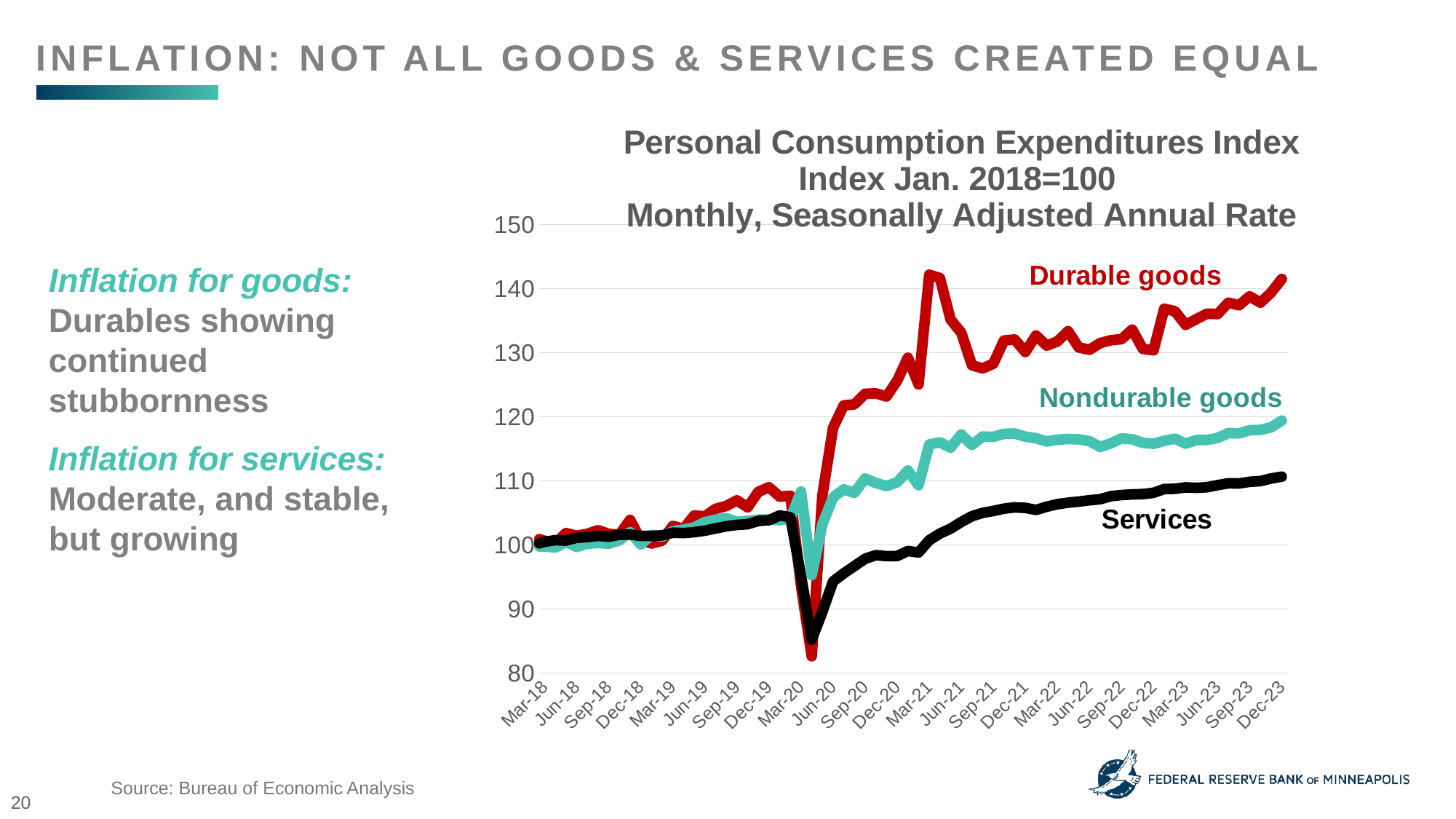
What kind of chart is shown on the slide? line chart Does the Services line generally rise or fall from Mar-21 to Dec-23? rise At Dec-23, which is larger: the value for Nondurable goods or the value for Services? Nondurable goods How many series are plotted on the chart? 3 What is the source of the data shown in the chart? Bureau of Economic Analysis What is the base period of the index according to the chart title? Jan. 2018=100 Is the value for Durable goods at Dec-23 greater or less than 130? greater Which series has the lowest value at Dec-23? Services Which series has the highest value at Dec-23? Durable goods Is the value for Services at Dec-23 greater or less than 120? less Is the value for Nondurable goods at Dec-23 greater or less than 110? greater